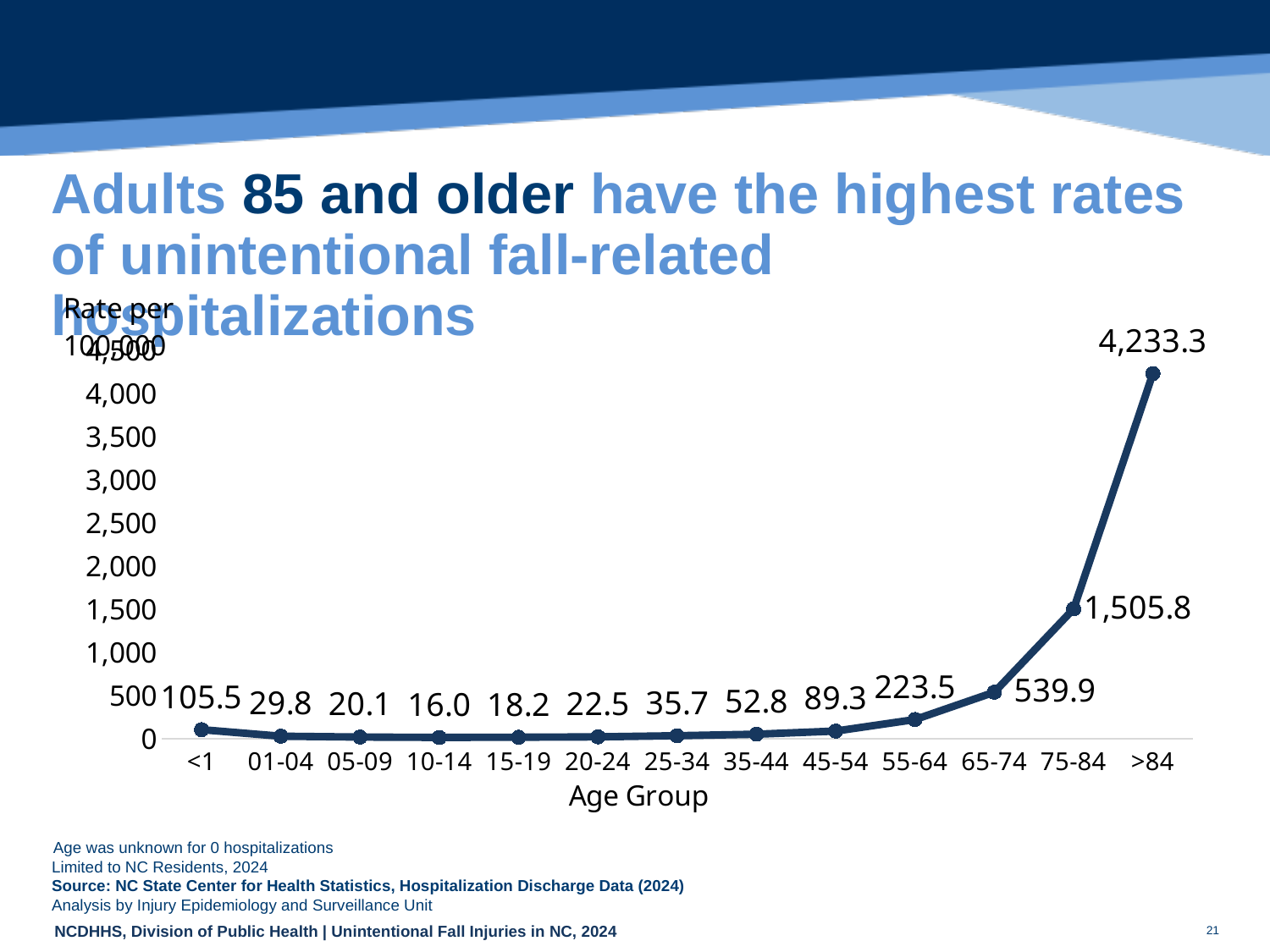
Which age group has a higher rate, <1 or 45-54? <1 What is the rate for the 75-84 age group? 1,505.8 What is the label of the x axis? Age Group What kind of chart is shown on the slide? line chart How many age groups are plotted on the chart? 13 Is the value for the 65-74 age group greater or less than 1,000? less What is the rate for the <1 age group? 105.5 Which age group has the highest rate of fall-related hospitalizations? >84 What is the rate for the 55-64 age group? 223.5 What is the rate of unintentional fall-related hospitalizations for the >84 age group? 4,233.3 What is the difference between the rates for the >84 and 75-84 age groups? 2,727.5 Which age group has the lowest rate of fall-related hospitalizations? 10-14